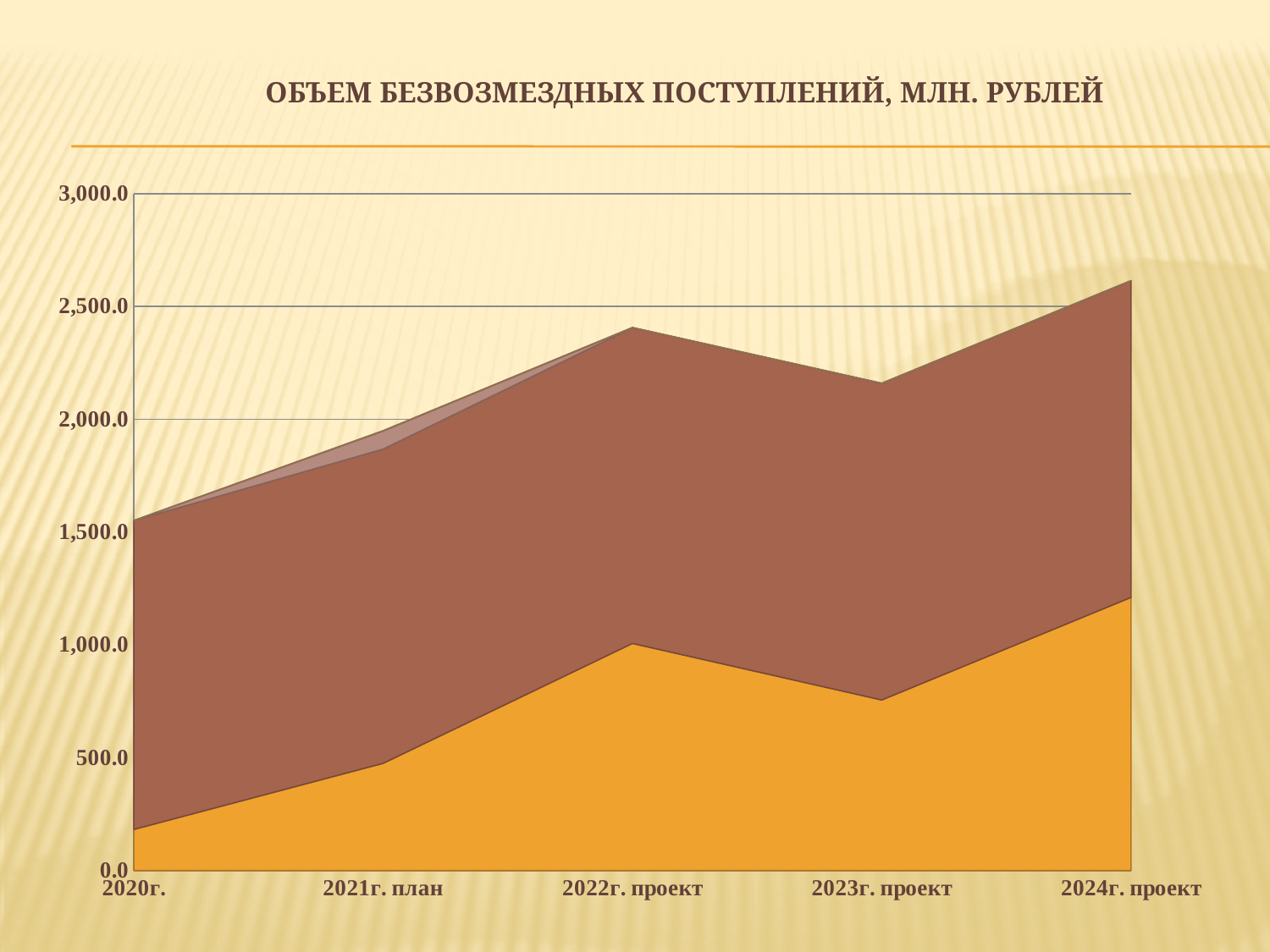
Is the total (top of the stacked area) for 2020г. greater or less than 1,500.0? greater What is the title of the chart? ОБЪЕМ БЕЗВОЗМЕЗДНЫХ ПОСТУПЛЕНИЙ, МЛН. РУБЛЕЙ In which category does the top of the stacked area reach its highest value? 2024г. проект Does the total rise or fall from 2020г. to 2022г. проект? rise How many categories are shown on the x axis? 5 In which category is the top of the stacked area lowest? 2020г. Is the total (top of the stacked area) for 2024г. проект greater or less than 2,500.0? greater What kind of chart is shown on the slide? area chart Is the total (top of the stacked area) for 2022г. проект greater or less than 2,500.0? less Which has the larger total: 2022г. проект or 2023г. проект? 2022г. проект